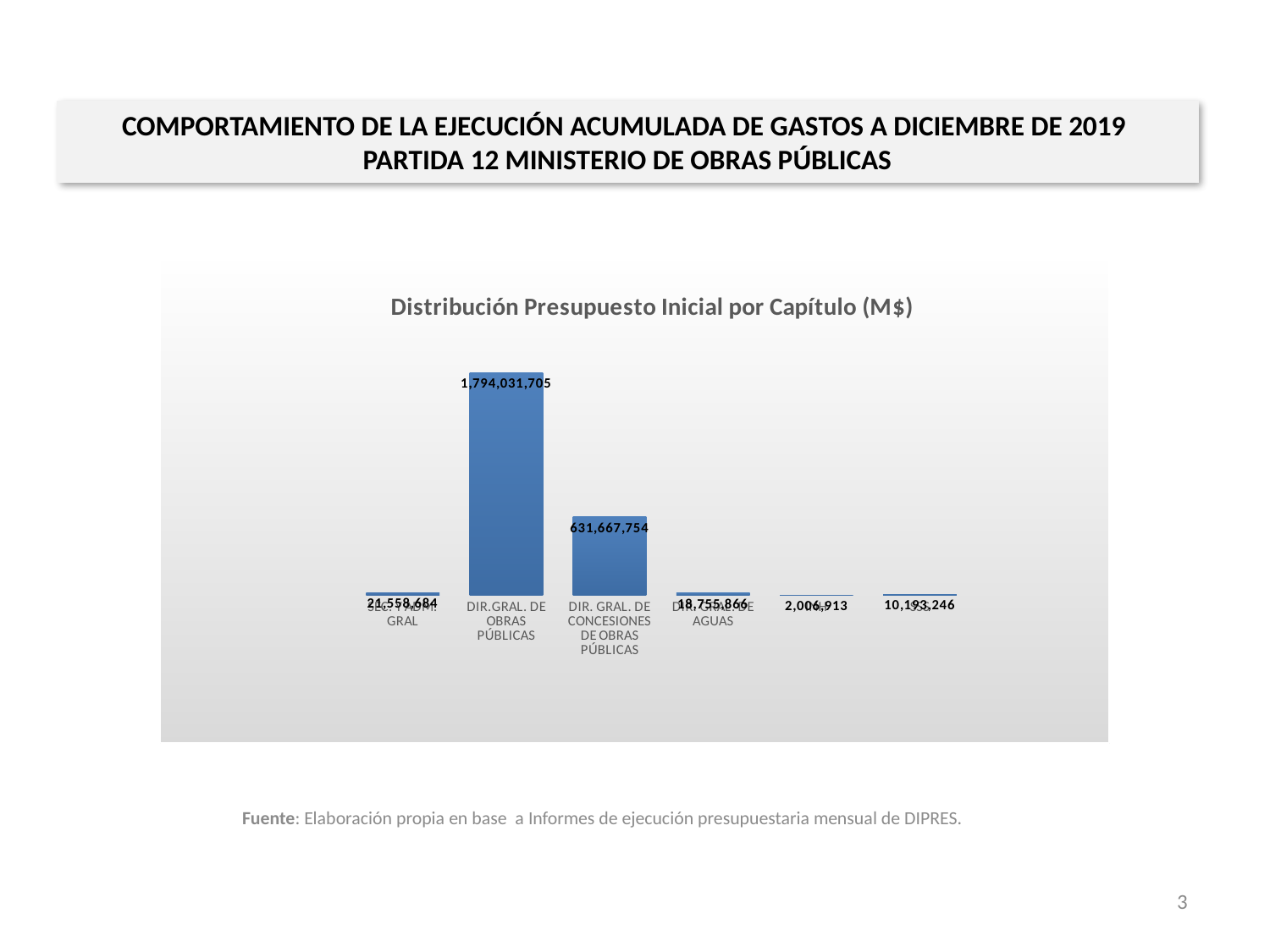
How many bars (categories) does the chart show? 6 What is the difference between the values for DIR.GRAL. DE OBRAS PÚBLICAS and DIR. GRAL. DE CONCESIONES DE OBRAS PÚBLICAS? 1,162,363,951 What is the difference between the values for SEC. Y ADM. GRAL and DIR. GRAL. DE AGUAS? 2,802,818 Which category has the highest value? DIR.GRAL. DE OBRAS PÚBLICAS What is the smallest value labelled on the chart? 2,006,913 Which is larger, the value for SEC. Y ADM. GRAL or the value for DIR. GRAL. DE AGUAS? SEC. Y ADM. GRAL What kind of chart is shown on the slide? bar chart What is the value for DIR. GRAL. DE AGUAS? 18,755,866 What is the title of the chart? Distribución Presupuesto Inicial por Capítulo (M$) What is the value for DIR.GRAL. DE OBRAS PÚBLICAS? 1,794,031,705 What is the value for SEC. Y ADM. GRAL? 21,558,684 What is the value for DIR. GRAL. DE CONCESIONES DE OBRAS PÚBLICAS? 631,667,754